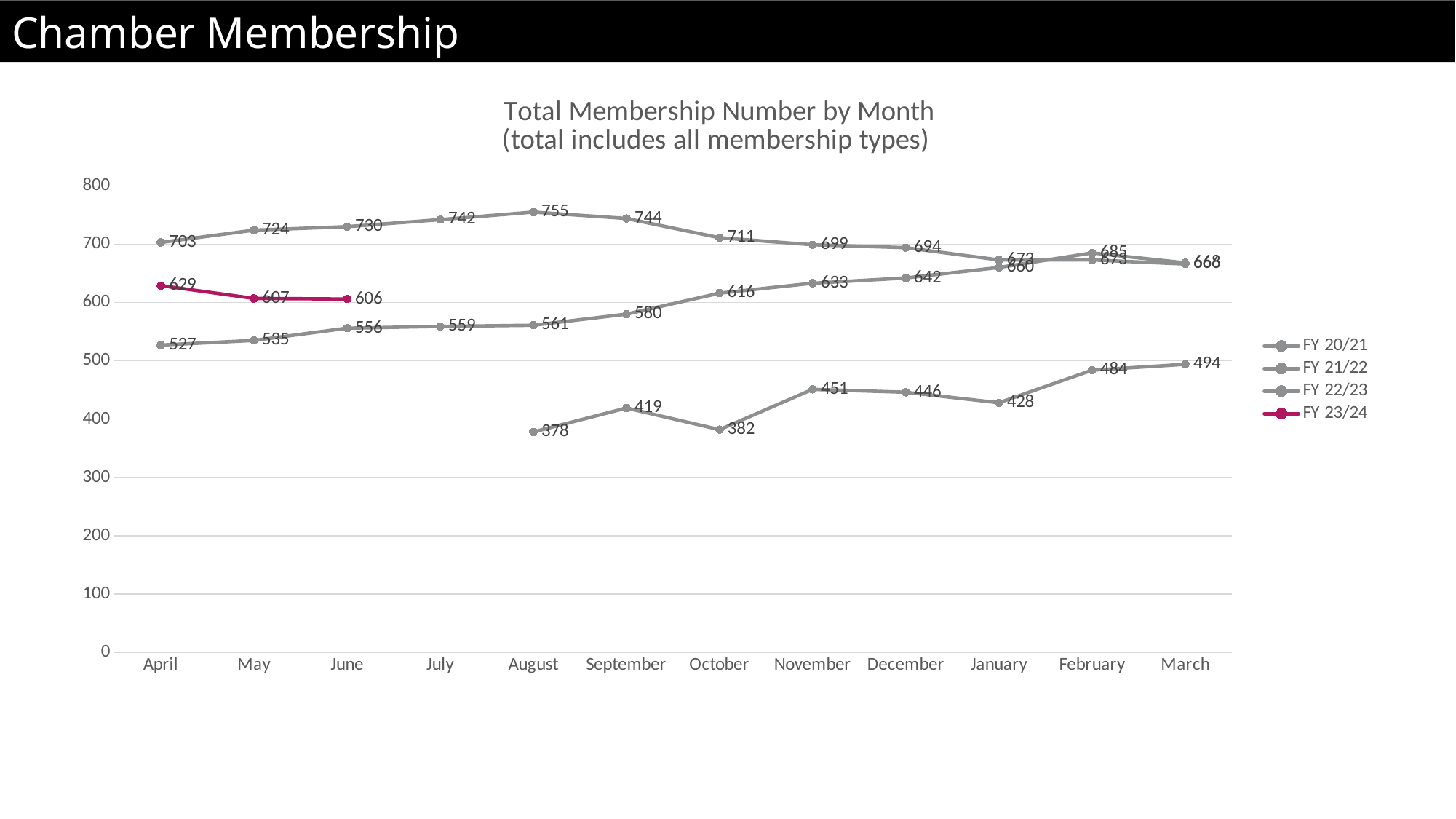
What is the difference between the FY 23/24 values for April and June? 23 What is the highest membership number plotted on the chart, and in which month does it occur? 755 in August What kind of chart is shown on the slide? line chart How many months are shown on the x axis? 12 Is the FY 23/24 value for April greater or less than 600? greater How many series does the legend list? 4 What is the FY 23/24 membership number for May? 607 What is the FY 23/24 membership number for April? 629 What colour is the FY 23/24 line? pink Does the FY 23/24 line rise or fall from April to June? fall What is the FY 23/24 membership number for June? 606 What is the lowest membership number plotted on the chart, and in which month does it occur? 378 in August